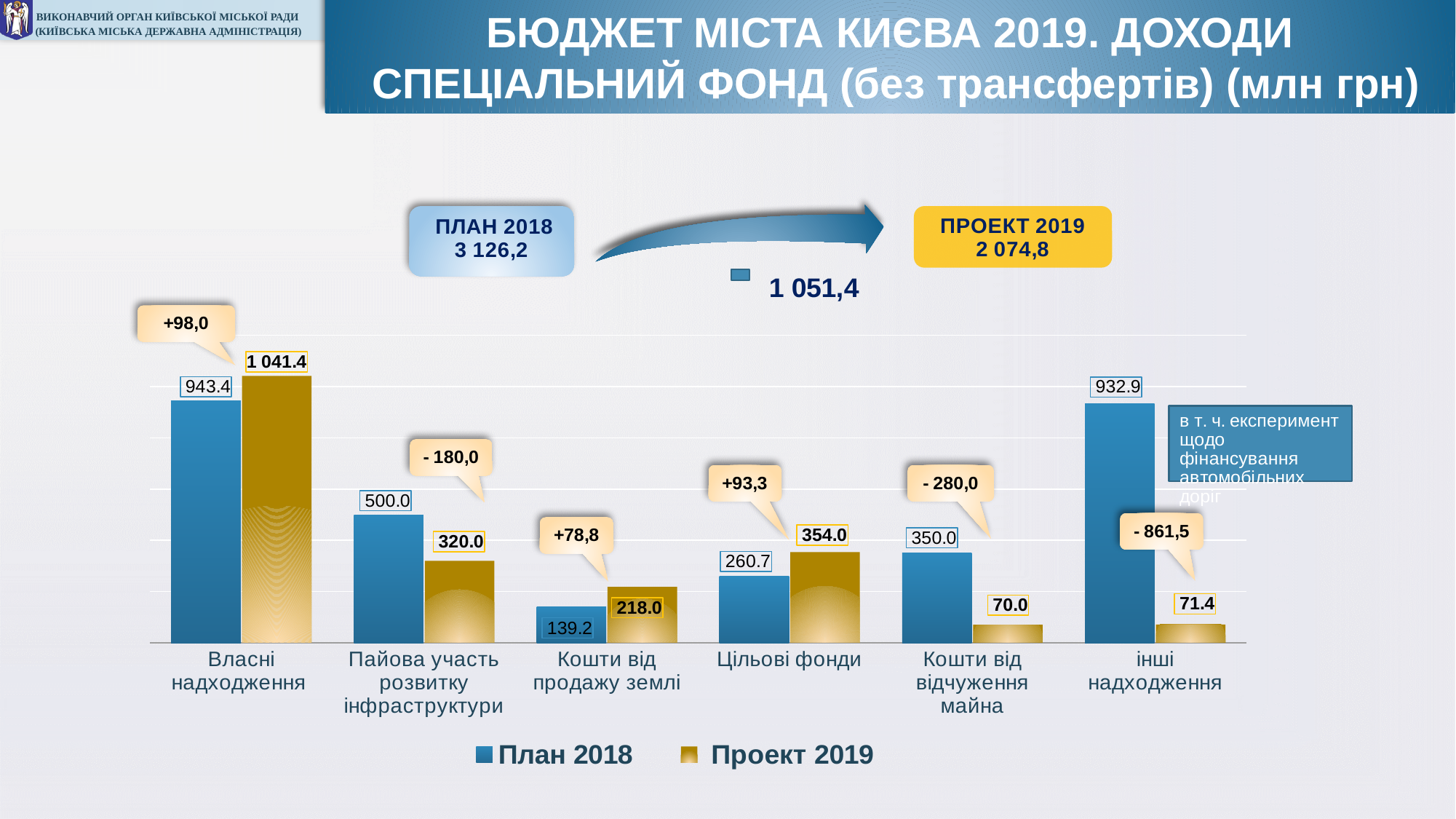
Which category has the highest Проект 2019 value? Власні надходження What is the Проект 2019 value for Власні надходження? 1 041.4 Which category has the lowest План 2018 value? Кошти від продажу землі What is the План 2018 value for Власні надходження? 943.4 How many series does the chart legend list? 2 What type of chart is shown on the slide? Bar chart Which category has the lowest Проект 2019 value? Кошти від відчуження майна What is the План 2018 value for Цільові фонди? 260.7 What is the difference between the План 2018 and Проект 2019 values for Пайова участь розвитку інфраструктури? 180.0 How many categories are shown on the x axis of the chart? 6 What is the Проект 2019 value for Кошти від продажу землі? 218.0 Which is larger for Цільові фонди: the План 2018 value or the Проект 2019 value? Проект 2019